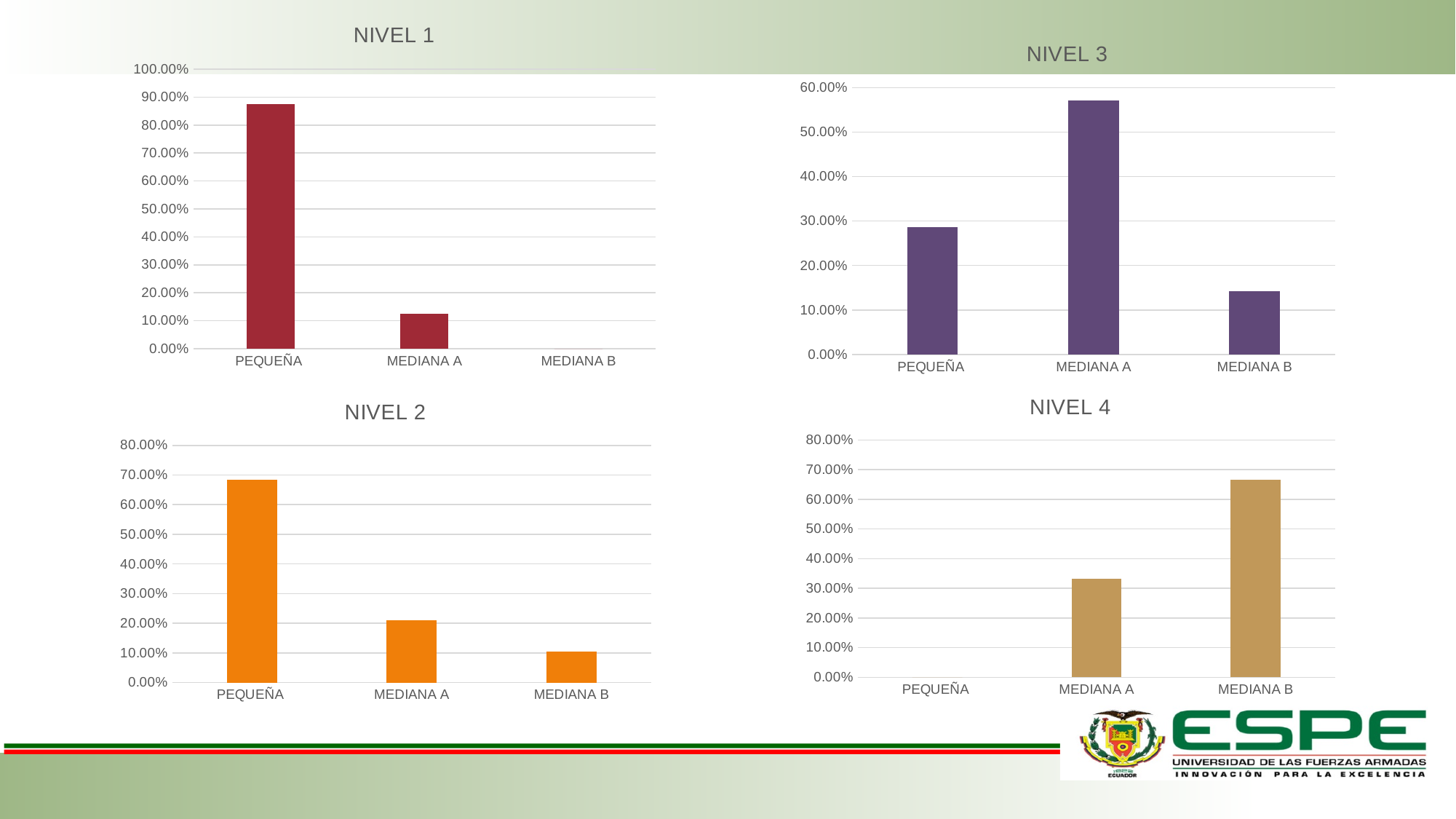
In the NIVEL 2 chart, which category has the lowest value? MEDIANA B In the NIVEL 1 chart, which category has the highest value? PEQUEÑA In the NIVEL 3 chart, is the value for MEDIANA A greater or less than 50.00%? greater In the NIVEL 3 chart, which is larger, PEQUEÑA or MEDIANA B? PEQUEÑA In the NIVEL 3 chart, which category has the highest value? MEDIANA A In the NIVEL 1 chart, is the value for PEQUEÑA greater or less than 80.00%? greater In the NIVEL 2 chart, which is larger, MEDIANA A or MEDIANA B? MEDIANA A In the NIVEL 4 chart, is the value for MEDIANA A greater or less than 40.00%? less In the NIVEL 4 chart, which category has the highest value? MEDIANA B How many categories are shown on the x axis of the NIVEL 4 chart? 3